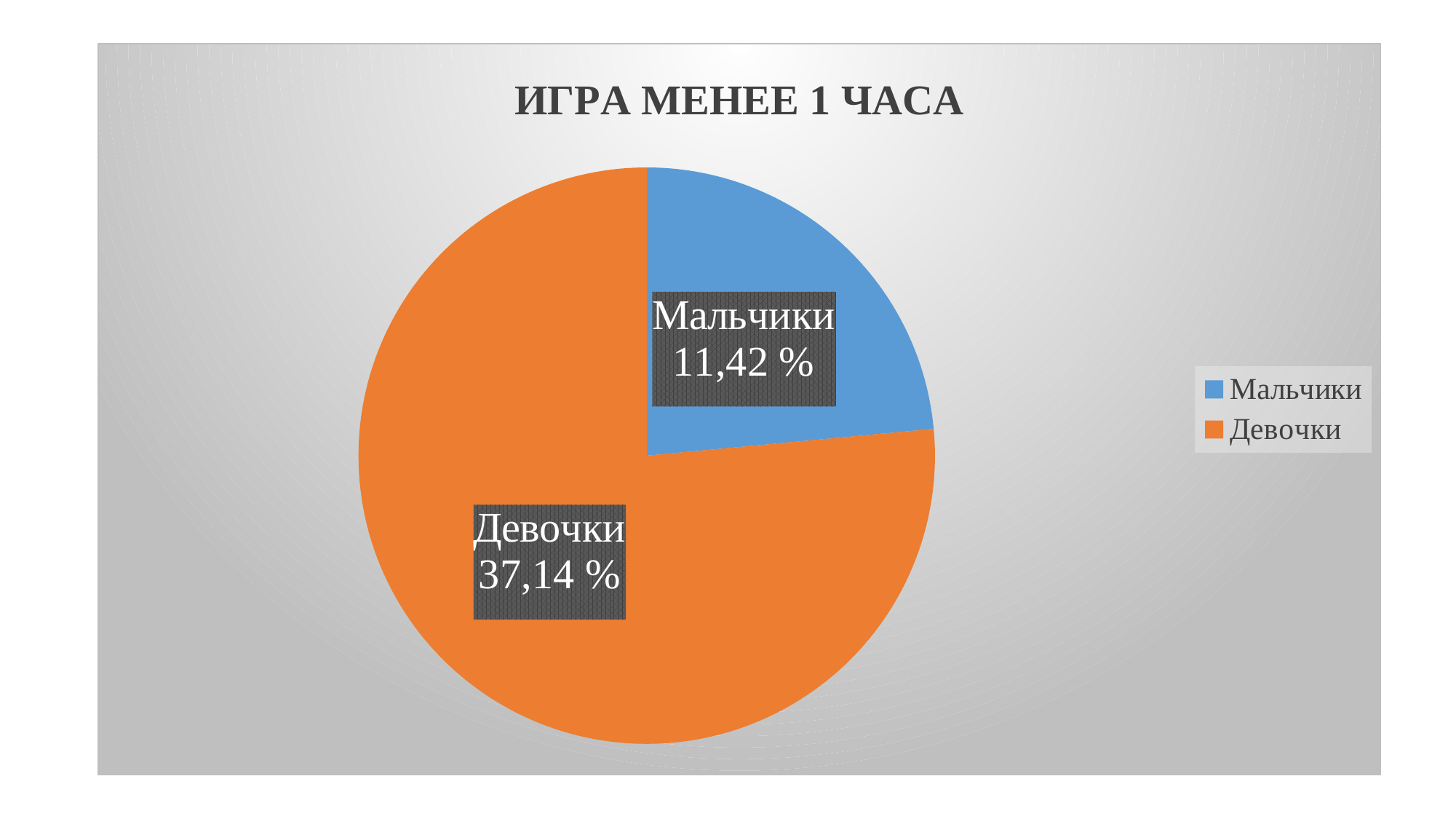
Which is larger, the value for Мальчики or the value for Девочки? Девочки Which category has the smallest slice of the pie? Мальчики What value is shown for Девочки? 37,14 % What colour is the slice for Девочки? orange How many entries does the legend list? 2 How many slices does the pie chart have? 2 Which category has the largest slice of the pie? Девочки What is the title of the chart? ИГРА МЕНЕЕ 1 ЧАСА What value is shown for Мальчики? 11,42 % What type of chart is shown on the slide? pie chart What is the difference between the value for Девочки and the value for Мальчики? 25,72 %